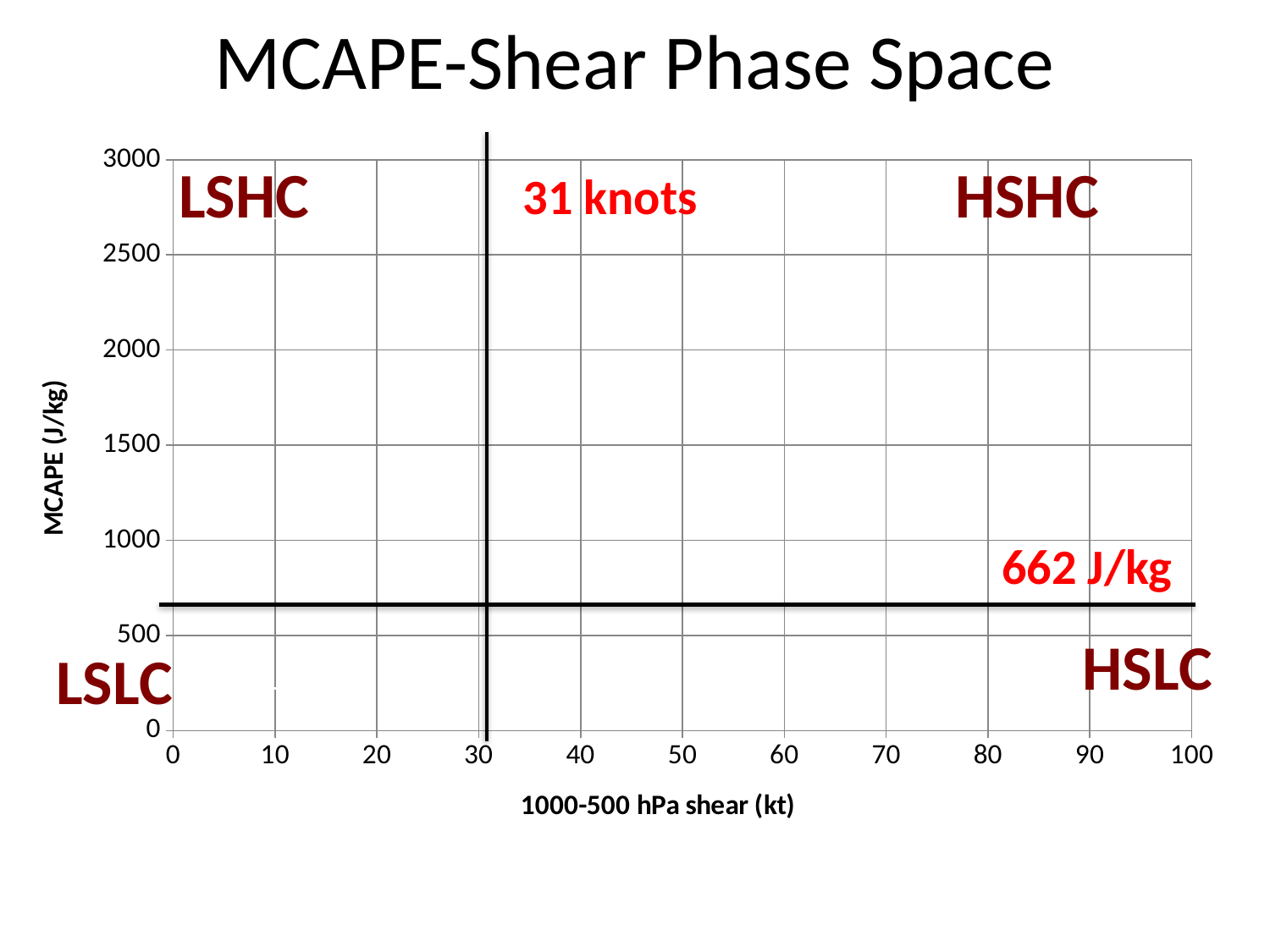
Which quadrant label appears in the lower-left region of the chart? LSLC What is the title of the chart? MCAPE-Shear Phase Space Which quadrant label appears in the upper-left region of the chart? LSHC Which quadrant label appears in the upper-right region of the chart? HSHC What MCAPE value does the horizontal black line mark? 662 J/kg Is the vertical threshold line at 31 knots to the right or left of the 30 tick on the x axis? right What shear value does the vertical black line mark? 31 knots Which quadrant label appears in the lower-right region of the chart? HSLC What is the label of the x axis? 1000-500 hPa shear (kt) Is the horizontal threshold line at 662 J/kg above or below the 500 gridline on the y axis? above